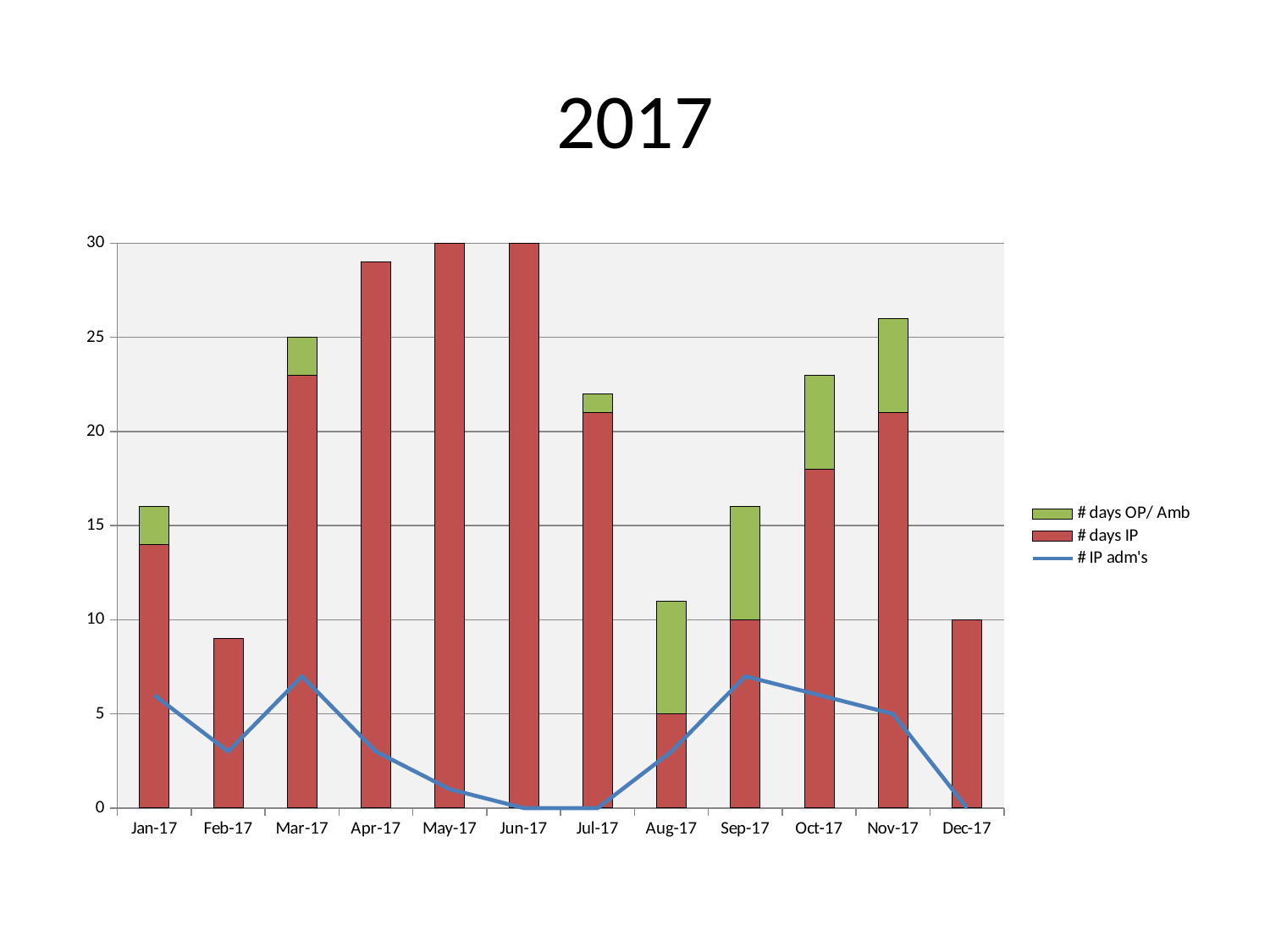
What is the title of the chart? 2017 How many months are shown on the x axis? 12 Is the total bar for Apr-17 greater or less than 25? greater What is the value of # days IP for Sep-17? 10 How many series does the legend list? 3 Is the total bar for Feb-17 greater or less than 10? less What kind of chart is shown on the slide? A bar chart with a line Is the total bar for Oct-17 greater or less than 20? greater Which has the taller total bar, Mar-17 or Apr-17? Apr-17 What is the value of # IP adm's in Jun-17? 0 What is the value of # days IP for Dec-17? 10